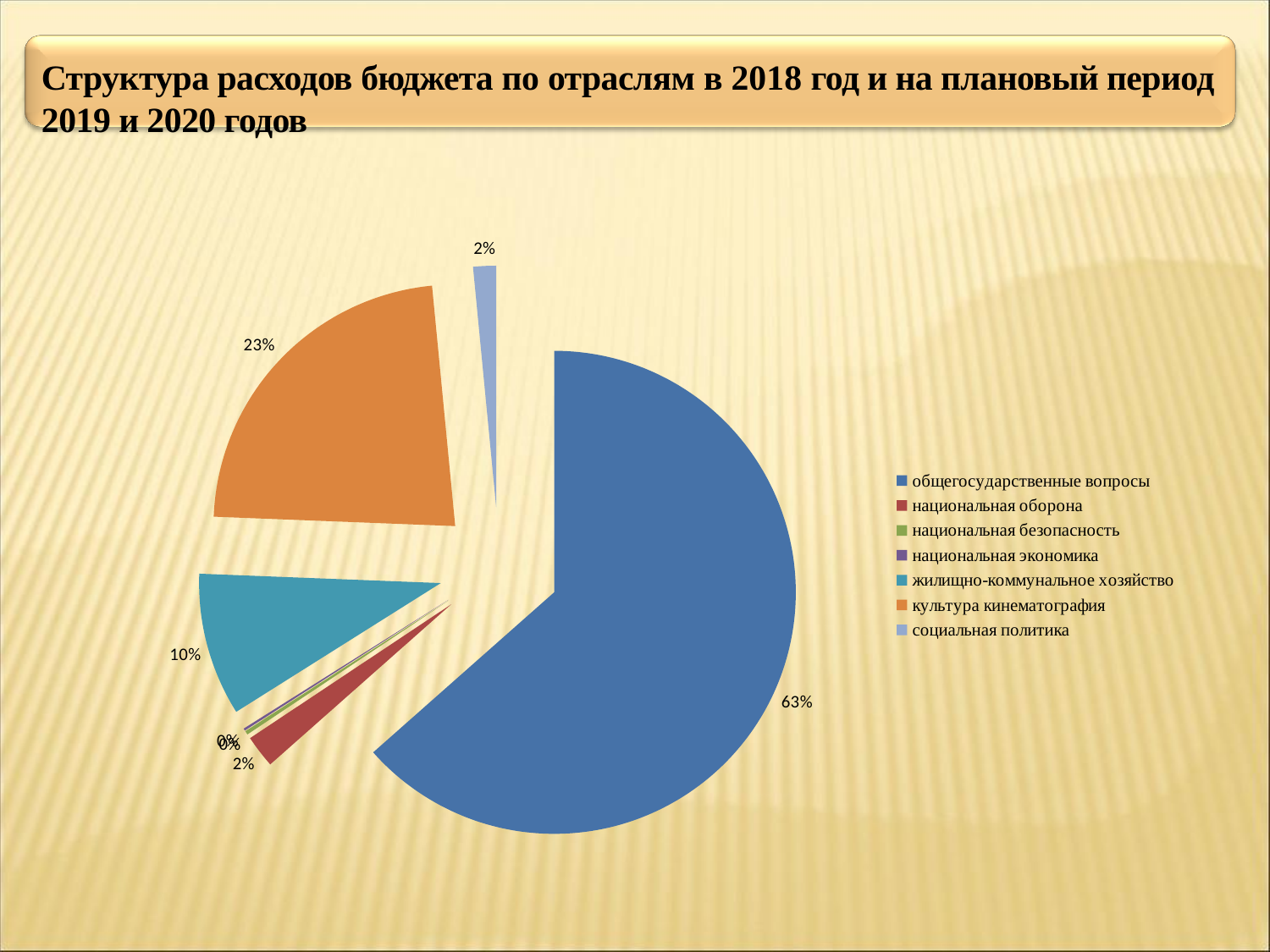
What share of the pie does общегосударственные вопросы take? 63% What is the title of the slide? Структура расходов бюджета по отраслям в 2018 год и на плановый период 2019 и 2020 годов What colour is the slice for жилищно-коммунальное хозяйство? teal What is the difference between the shares of общегосударственные вопросы and культура кинематография? 40 percentage points Which is larger, the share of культура кинематография or the share of жилищно-коммунальное хозяйство? культура кинематография Which category has the largest slice of the pie? общегосударственные вопросы What share of the pie does социальная политика take? 2% What kind of chart is shown on the slide? pie chart What share of the pie does жилищно-коммунальное хозяйство take? 10% How many categories does the legend list? 7